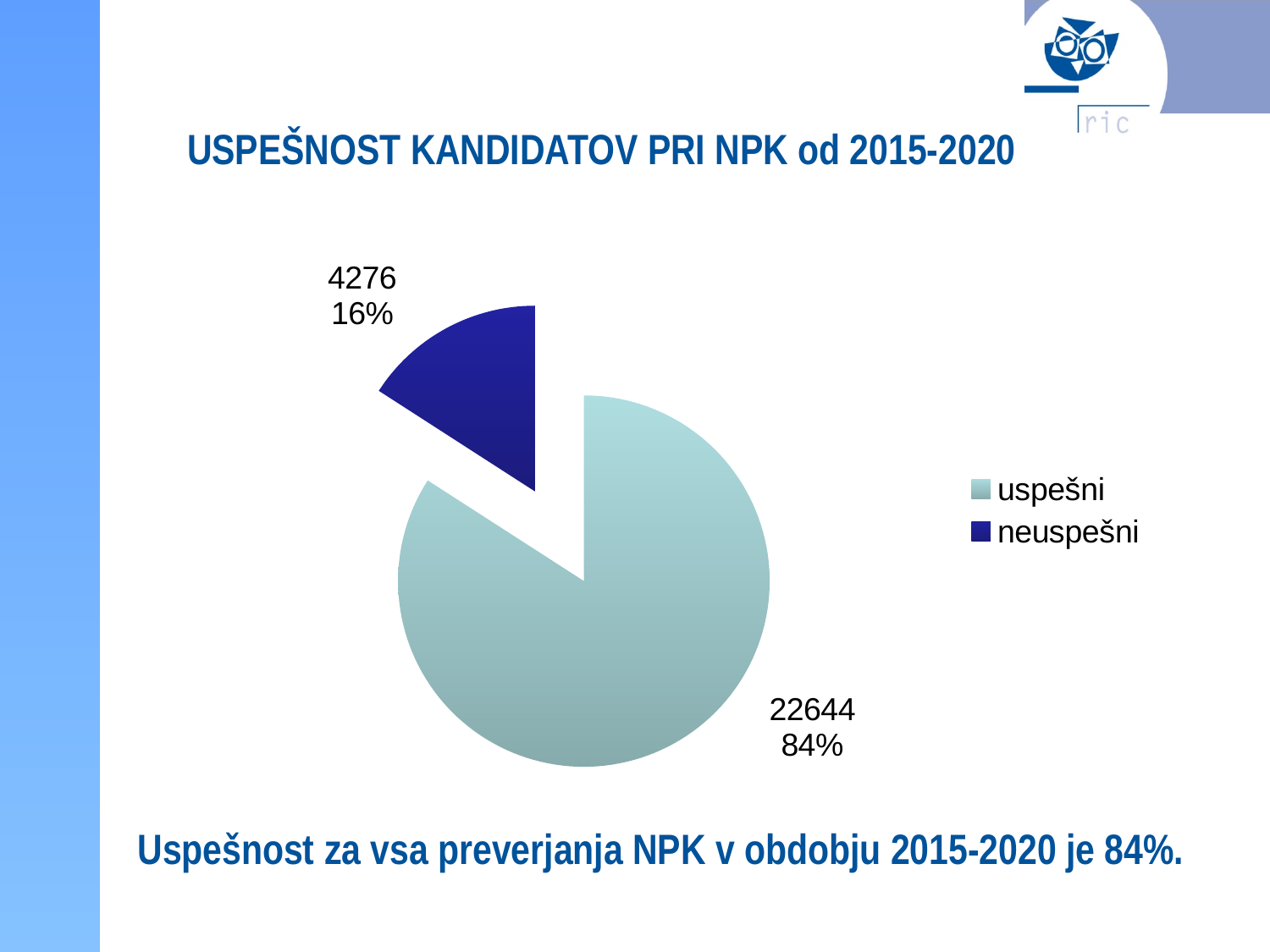
Which category has the smallest slice? neuspešni What is the value for neuspešni? 4276 What kind of chart is shown on the slide? pie chart Which category has the largest slice? uspešni How many slices does the pie chart have? 2 What is the total of the two slices? 26920 What is the value for uspešni? 22644 What is the difference between the values for uspešni and neuspešni? 18368 What share of the pie does the uspešni slice represent? 84% Which is larger, uspešni or neuspešni? uspešni What share of the pie does the neuspešni slice represent? 16% How many series does the legend list? 2